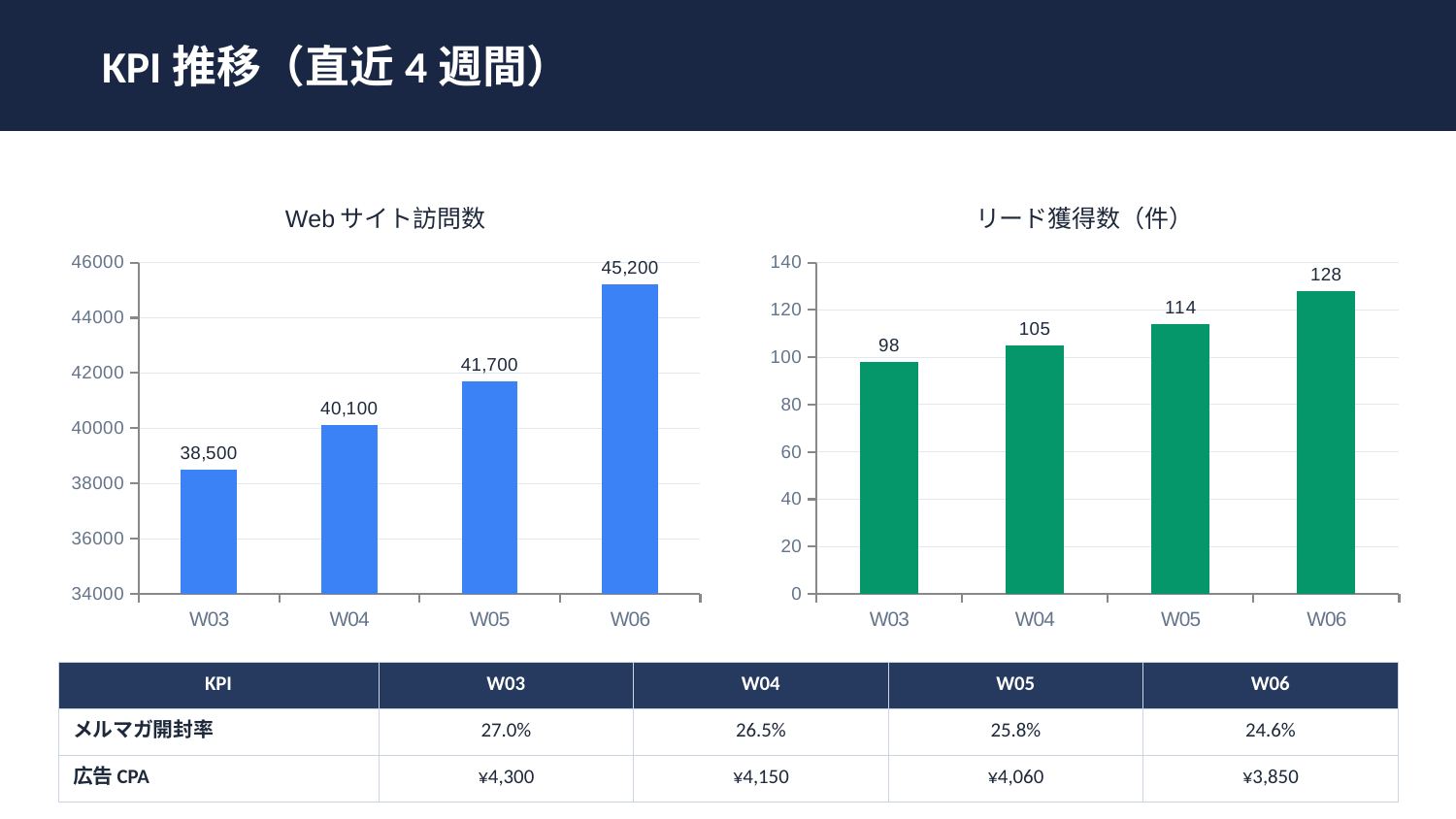
In the リード獲得数（件） chart, what is the value for W05? 114 How many weeks are shown in the リード獲得数（件） chart? 4 In the Web サイト訪問数 chart, what is the difference between W06 and W03? 6,700 In the リード獲得数（件） chart, which week has the lowest value? W03 In the リード獲得数（件） chart, what is the difference between W06 and W05? 14 What kind of chart is the Web サイト訪問数 chart? bar chart In the リード獲得数（件） chart, which is larger, W04 or W05? W05 In the Web サイト訪問数 chart, do the values rise or fall from W03 to W06? rise What colour are the bars in the リード獲得数（件） chart? green In the Web サイト訪問数 chart, which week has the highest value? W06 In the Web サイト訪問数 chart, is the value for W05 greater or less than 40000? greater In the Web サイト訪問数 chart, what is the value for W04? 40,100